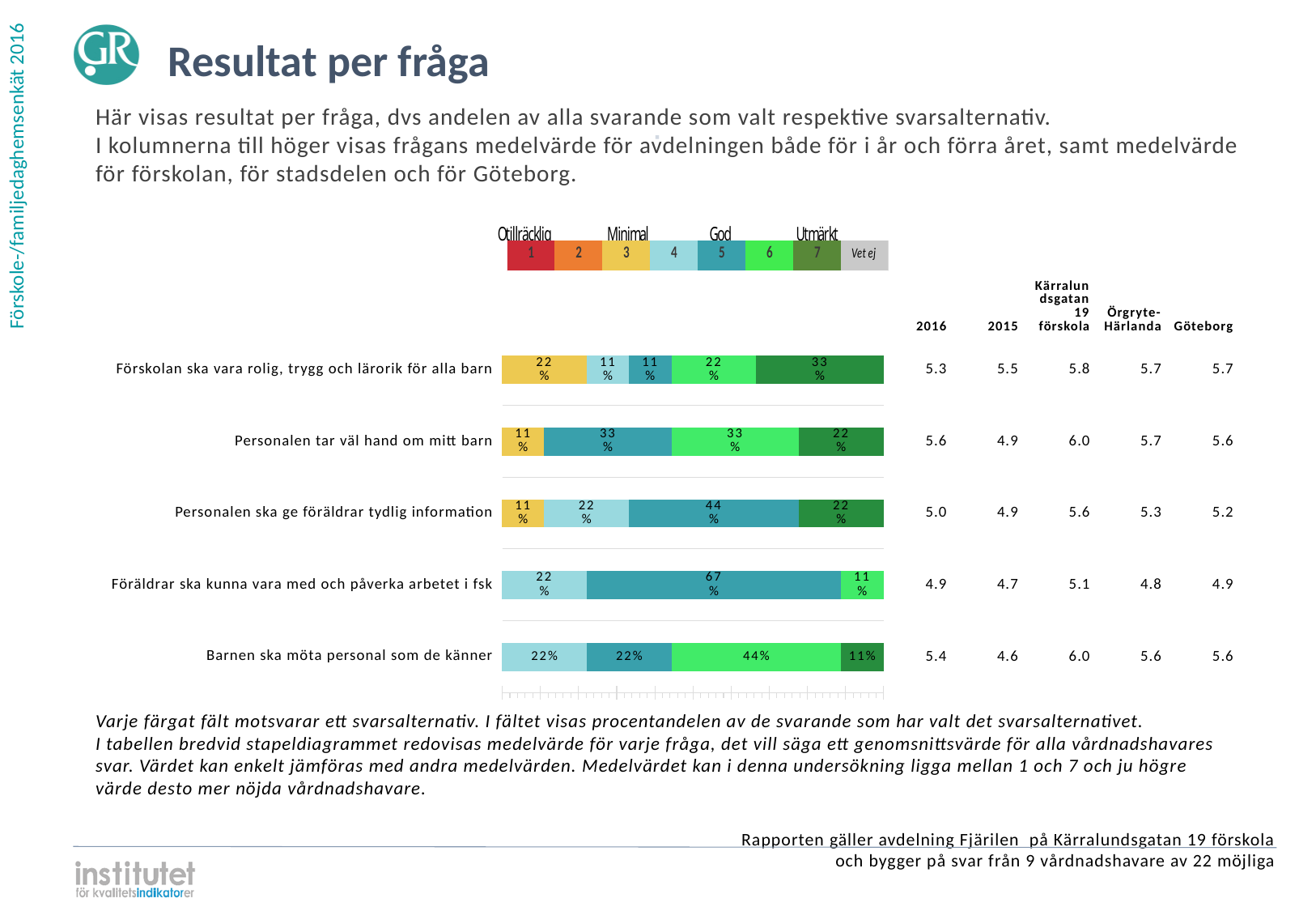
How many answer alternatives are shown in the colour legend above the chart, including 'Vet ej'? 8 What label does the legend give to answer alternatives 1 and 2 (red and orange)? Otillräcklig How many questions (categories) are shown as bars in the chart? 5 For 'Förskolan ska vara rolig, trygg och lärorik för alla barn', which is larger: the share choosing answer 3 or the share choosing answer 7? Answer 7 (33%) What kind of chart is used to show the results per question? Stacked bar chart Which answer alternative has the largest share for 'Personalen ska ge föräldrar tydlig information'? 5 (44%) Which question has the lowest 2016 mean value in the table? Föräldrar ska kunna vara med och påverka arbetet i fsk (4.9) What percentage of respondents chose answer 7 (Utmärkt, dark green) for 'Förskolan ska vara rolig, trygg och lärorik för alla barn'? 33% For 'Personalen tar väl hand om mitt barn', what is the difference between the share choosing answer 5 and the share choosing answer 7? 11% What percentage of respondents chose answer 6 (light green) for 'Barnen ska möta personal som de känner'? 44% What is the 2016 mean value for 'Personalen tar väl hand om mitt barn'? 5.6 What percentage of respondents chose answer 5 (teal) for 'Föräldrar ska kunna vara med och påverka arbetet i fsk'? 67%